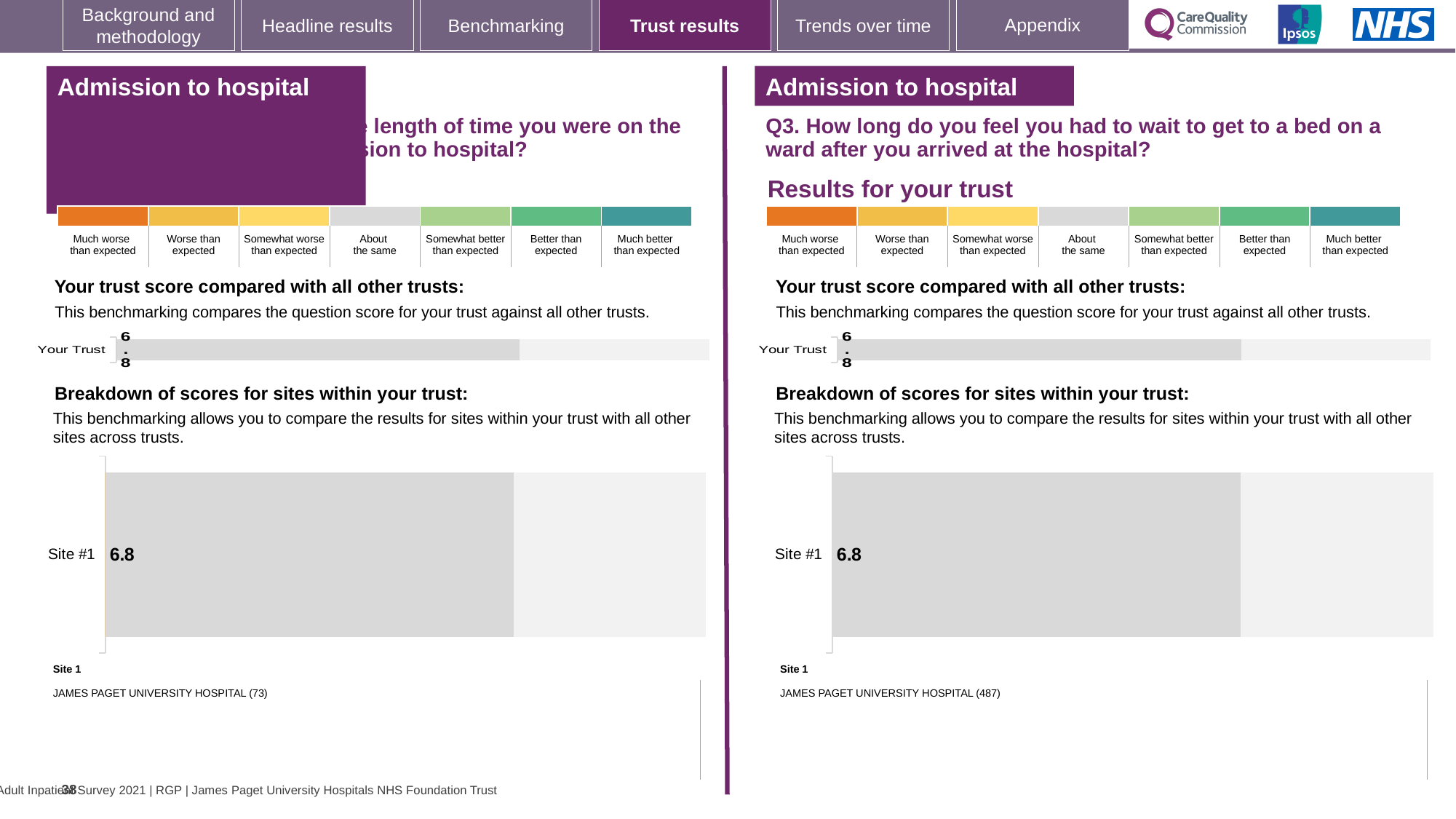
On the right half of the slide (Q3), is the Your Trust score larger than the Site #1 score, or are they equal? they are equal On the right half of the slide (Q3), what score is shown for Site #1 in the 'Breakdown of scores for sites within your trust' chart? 6.8 On the right half of the slide (Q3), what score is shown for Your Trust in the 'Your trust score compared with all other trusts' chart? 6.8 How many categories does the colour scale above the charts on the right half of the slide show, from 'Much worse than expected' to 'Much better than expected'? 7 On the left half of the slide, what score is shown for Site #1 in the 'Breakdown of scores for sites within your trust' chart? 6.8 On the right half of the slide, which hospital is listed as Site 1 below the breakdown chart? JAMES PAGET UNIVERSITY HOSPITAL (487) On the left half of the slide, what is the difference between the Your Trust score and the Site #1 score? 0 How many sites are plotted in the 'Breakdown of scores for sites within your trust' chart on the right half of the slide? 1 On the left half of the slide, what score is shown for Your Trust in the 'Your trust score compared with all other trusts' chart? 6.8 What kind of chart is used for the 'Breakdown of scores for sites within your trust' on the right half of the slide? bar chart